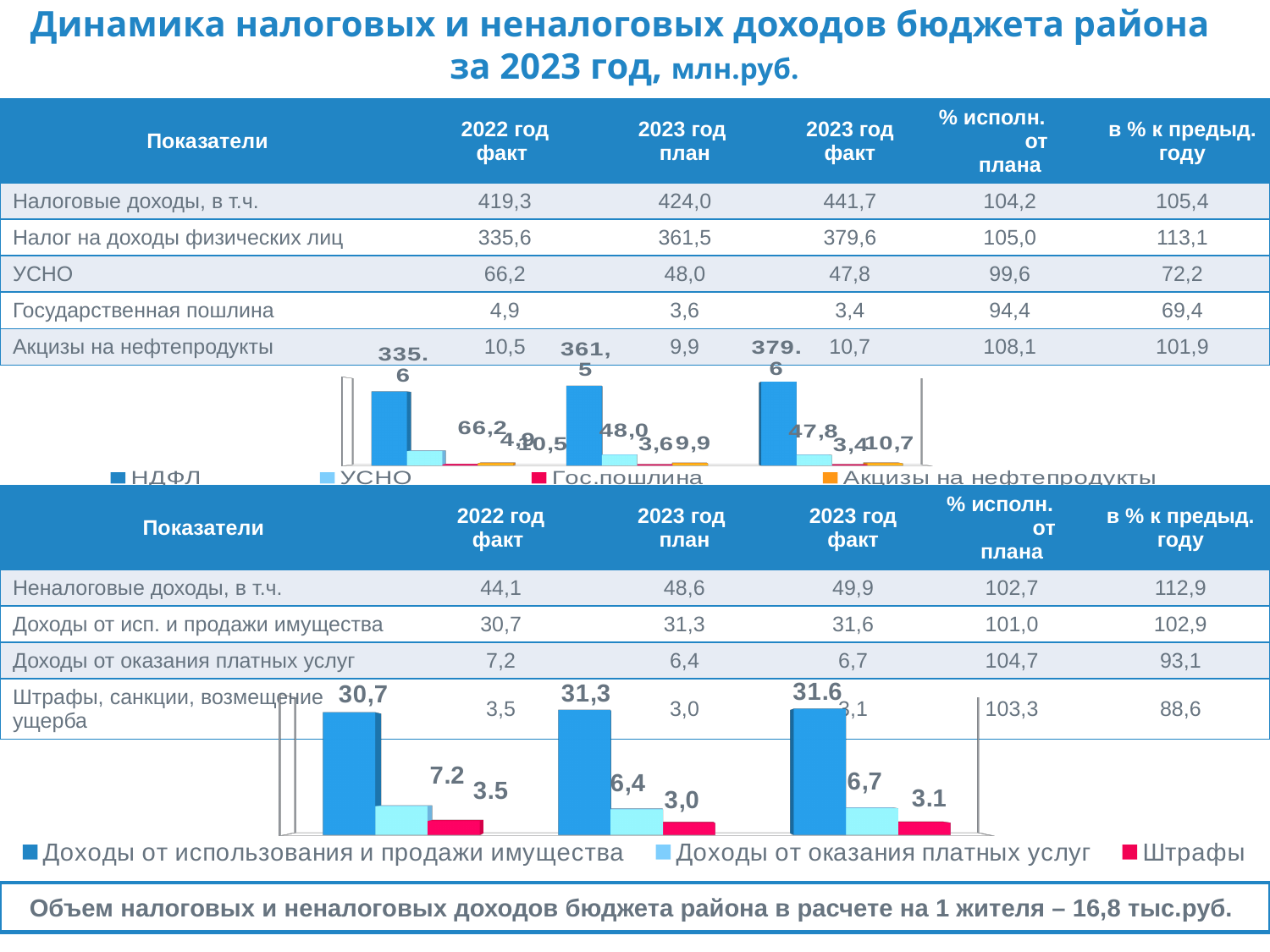
In the lower chart, which series has the highest bar in the right group? Доходы от использования и продажи имущества How many series does the legend of the upper chart list? 4 In the upper chart, which is larger in the left group: the УСНО bar or the Гос.пошлина bar? УСНО How many series does the legend of the lower chart list? 3 What kind of chart is the lower chart? bar chart In the upper chart, what is the value of the НДФЛ bar in the third (right) group? 379.6 In the lower chart, what is the value of the Доходы от использования и продажи имущества bar in the first (left) group? 30,7 In the lower chart, what is the value of the Штрафы bar in the middle group? 3,0 In the upper chart, do the НДФЛ values rise or fall from the left group to the right group? rise In the upper chart, what is the value of the УСНО bar in the first (left) group? 66,2 In the lower chart, what is the difference between the Доходы от использования и продажи имущества values in the right group (31.6) and the left group (30,7)? 0.9 In the upper chart, which series has the lowest bar in the first (left) group? Гос.пошлина